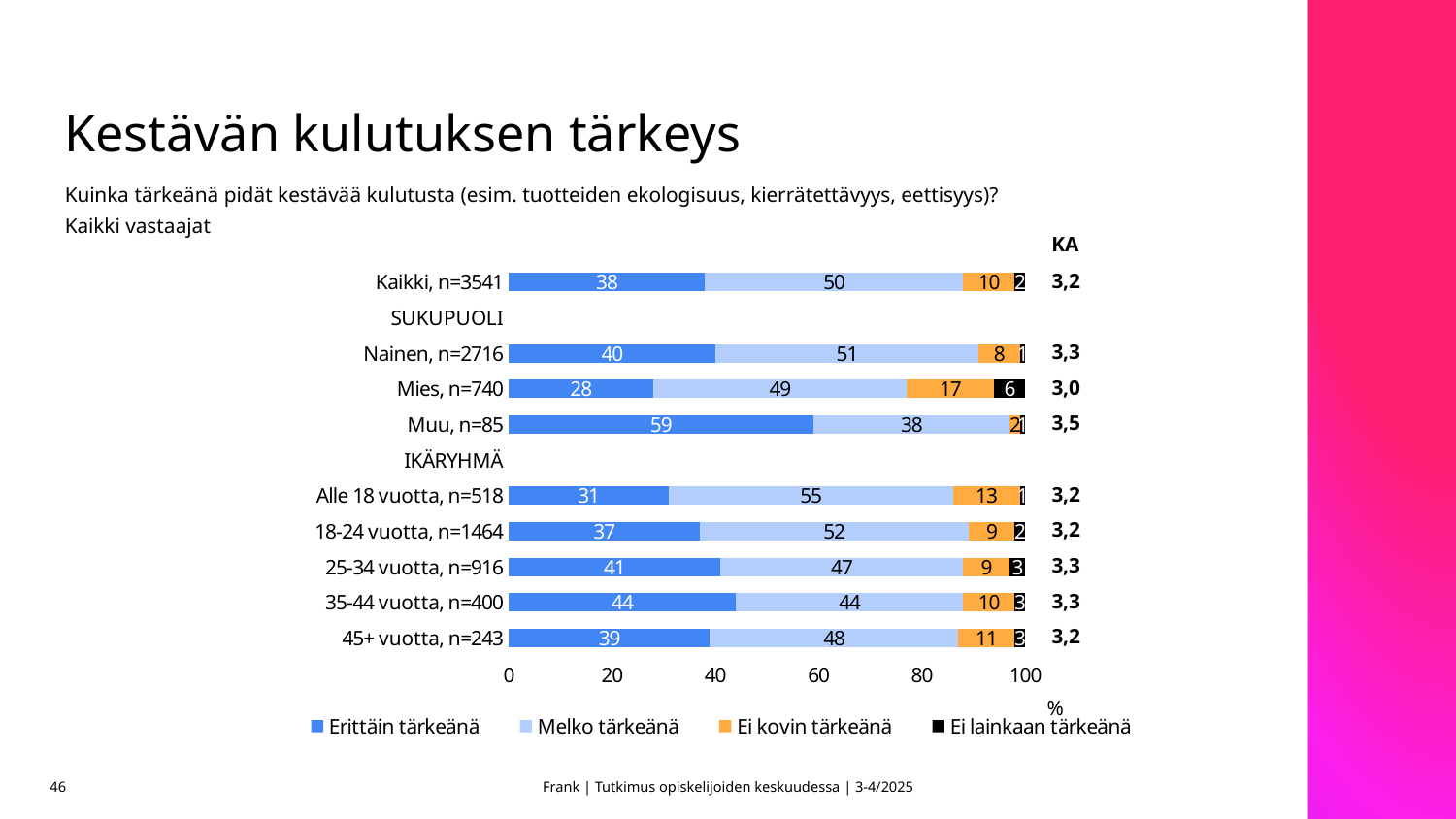
What is the 'Ei kovin tärkeänä' value for 'Mies, n=740'? 17 What is the 'Erittäin tärkeänä' value for 'Kaikki, n=3541'? 38 What is the 'Ei lainkaan tärkeänä' value for 'Mies, n=740'? 6 Which group has the lowest 'Erittäin tärkeänä' value? Mies, n=740 Which is larger: the 'Melko tärkeänä' value for 'Alle 18 vuotta, n=518' or for '25-34 vuotta, n=916'? Alle 18 vuotta, n=518 What is the KA value shown for 'Muu, n=85'? 3,5 What is the 'Ei kovin tärkeänä' value for '45+ vuotta, n=243'? 11 How many series does the legend list? 4 What is the 'Melko tärkeänä' value for 'Nainen, n=2716'? 51 Which group has the highest 'Erittäin tärkeänä' value? Muu, n=85 What kind of chart is shown on the slide? Stacked bar chart What is the difference between the 'Erittäin tärkeänä' values for 'Muu, n=85' and 'Mies, n=740'? 31